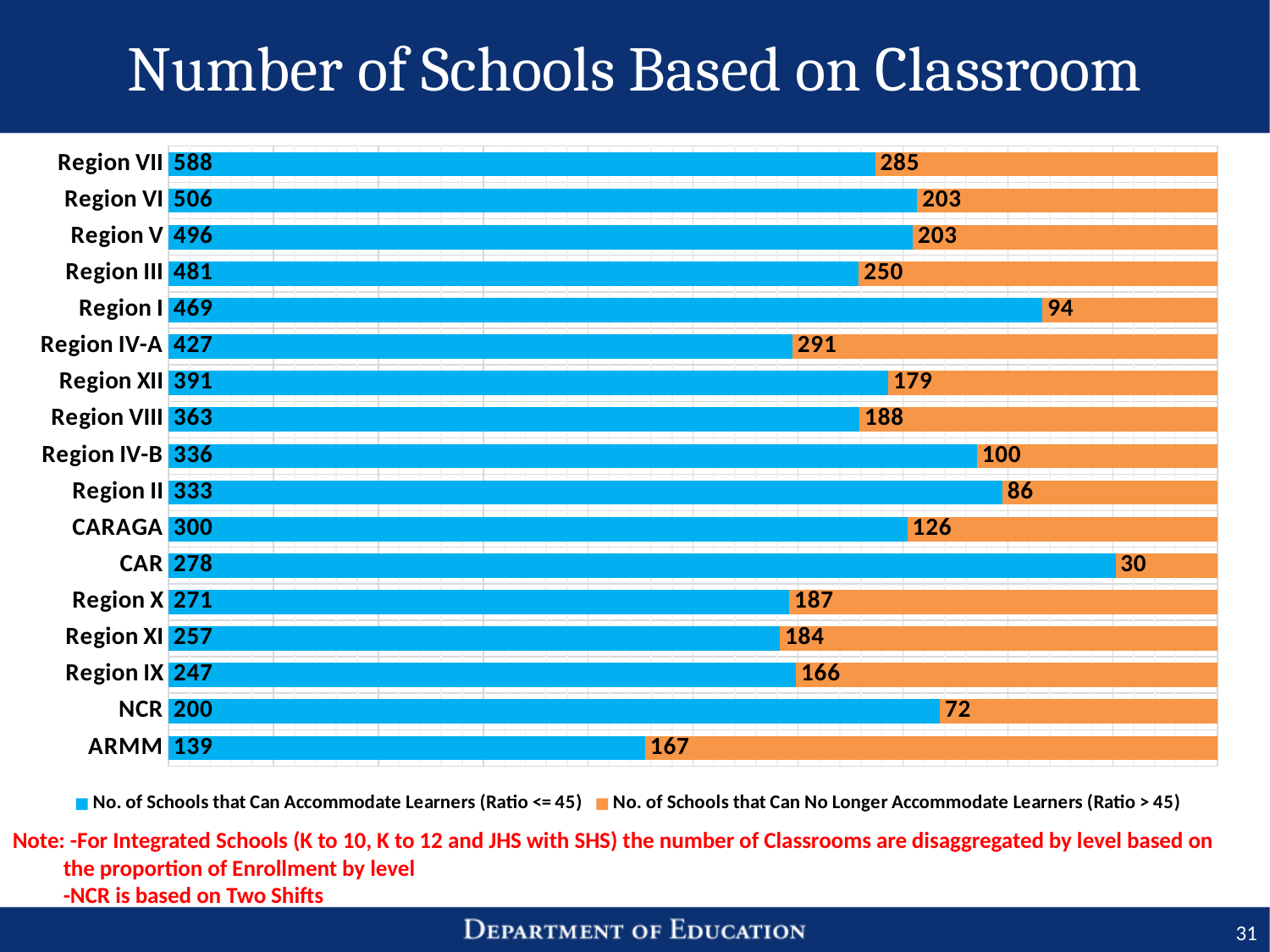
What is the number of schools that can no longer accommodate learners (Ratio > 45) in Region IV-A? 291 What type of chart is shown on the slide? Stacked bar chart How many regions are plotted in the chart? 17 What is the total number of schools shown for Region VII? 873 Which region has the lowest number of schools that can accommodate learners (Ratio <= 45)? ARMM Which region has the highest number of schools that can accommodate learners (Ratio <= 45)? Region VII How many series does the legend list? 2 What is the number of schools that can no longer accommodate learners (Ratio > 45) in CAR? 30 What is the difference between the number of schools that can accommodate learners and those that can no longer accommodate learners in Region I? 375 What is the number of schools that can accommodate learners (Ratio <= 45) in Region VII? 588 Which region has the lowest number of schools that can no longer accommodate learners (Ratio > 45)? CAR Which is larger in ARMM: the number of schools that can accommodate learners or the number that can no longer accommodate learners? No. of Schools that Can No Longer Accommodate Learners (Ratio > 45)